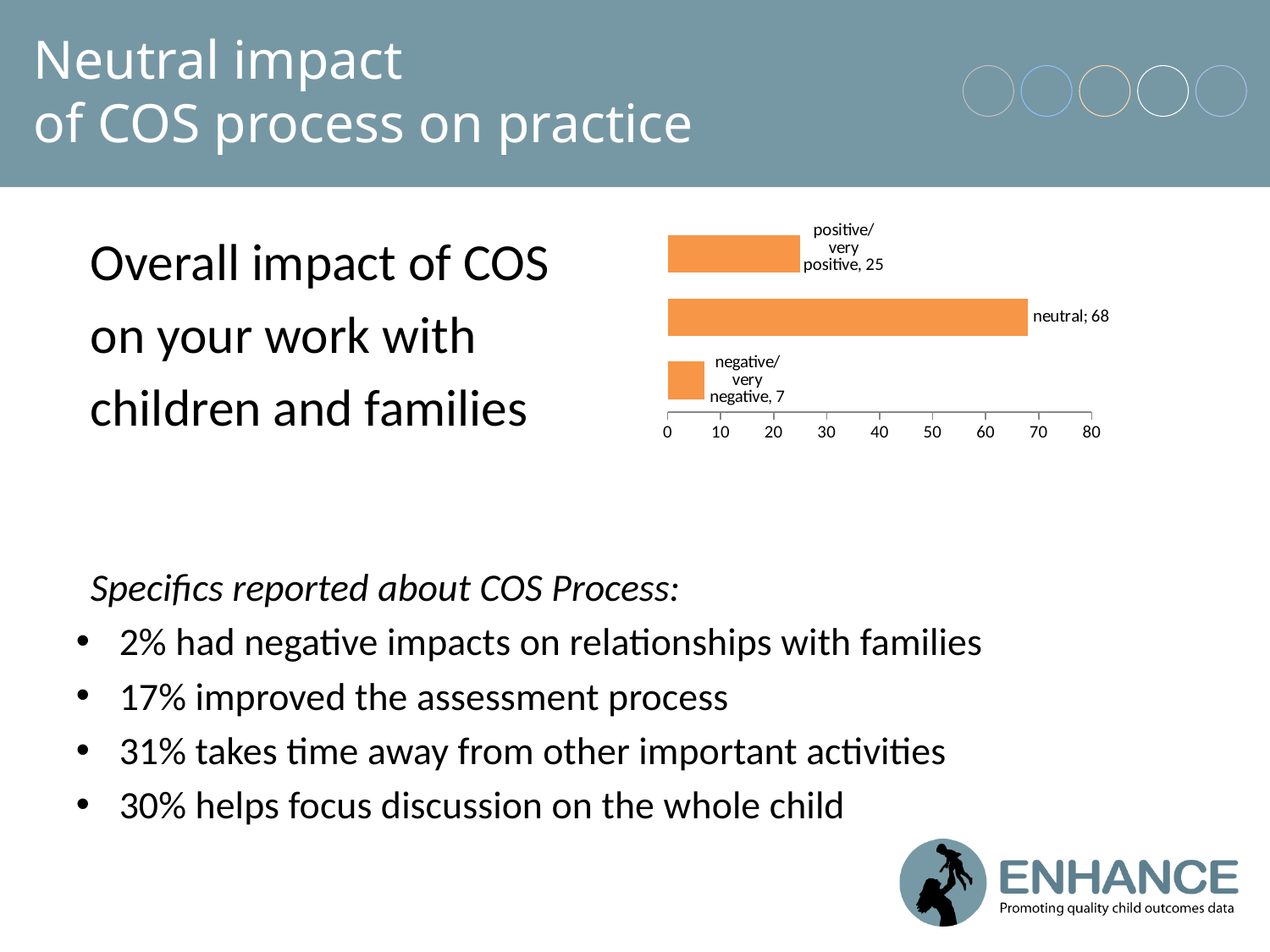
What is the difference between the positive/very positive value and the negative/very negative value? 18 What is the highest value shown on the chart's axis? 80 What is the value for negative/very negative? 7 How many categories are shown in the chart? 3 Which category has the lowest value? negative/very negative Which is larger, the value for positive/very positive or the value for negative/very negative? positive/very positive What is the difference between the neutral value and the positive/very positive value? 43 What is the value for neutral? 68 Which category has the highest value? neutral What is the value for positive/very positive? 25 What kind of chart is shown on the slide? bar chart Is the value for neutral greater or less than 60? greater